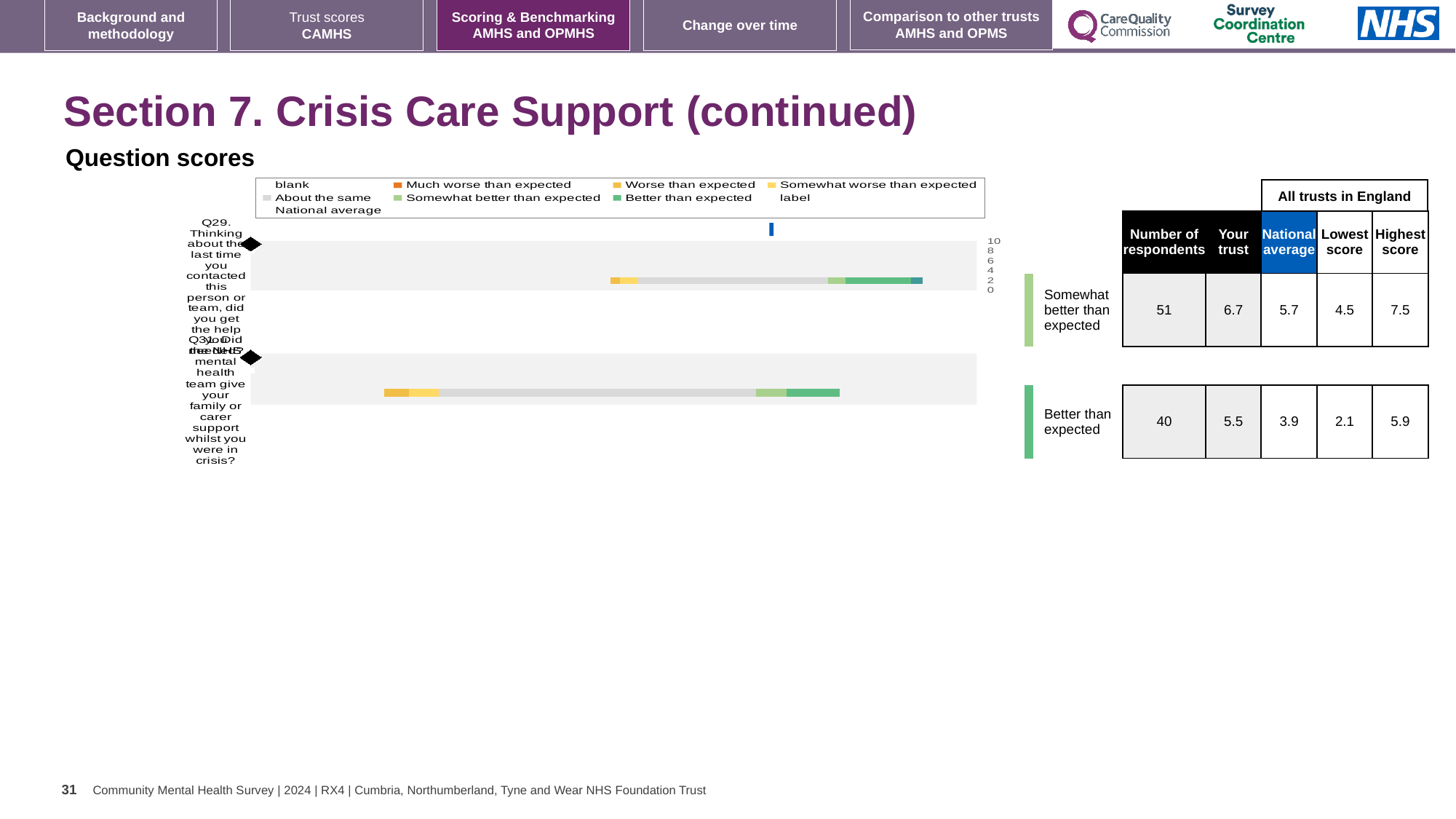
Which benchmark category is the trust's Q31 score placed in? Better than expected How many respondents answered Q29? 51 How many questions are plotted in the question scores chart? 2 Which benchmark category is the trust's Q29 score placed in? Somewhat better than expected What is the lowest score across all trusts in England for Q29? 4.5 What is the highest score across all trusts in England for Q31? 5.9 What is the national average score for Q31? 3.9 What is the difference between the trust's score and the national average for Q29? 1.0 Which question has the higher 'Your trust' score, Q29 or Q31? Q29 What type of chart is used to show the question scores on this slide? bar chart How many entries does the legend of the question scores chart list? 9 What is the 'Your trust' score for Q29 in the table beside the chart? 6.7